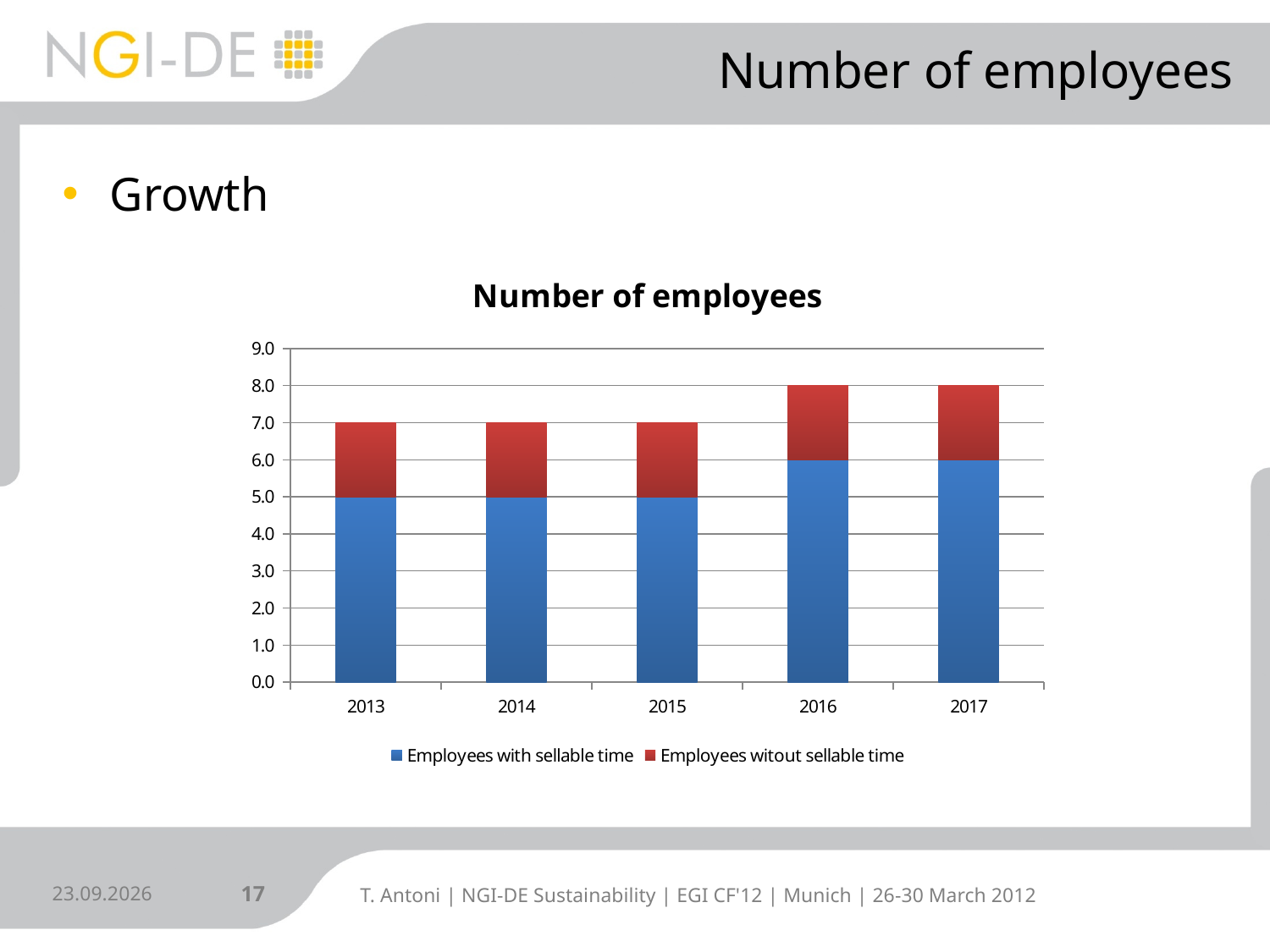
What is the title of the chart? Number of employees What is the value for Employees with sellable time in 2013? 5.0 Which year has the highest total number of employees, 2014 or 2016? 2016 What kind of chart is shown on the slide? stacked bar chart What is the total height of the stacked bar for 2015? 7.0 How many years are shown on the x axis? 5 Is the total value for 2014 greater or less than 8.0? less Which colour represents Employees witout sellable time in the chart? red How many series does the legend list? 2 What is the total height of the stacked bar for 2017? 8.0 Do the total values rise or fall from 2013 to 2017? rise What is the value for Employees with sellable time in 2016? 6.0